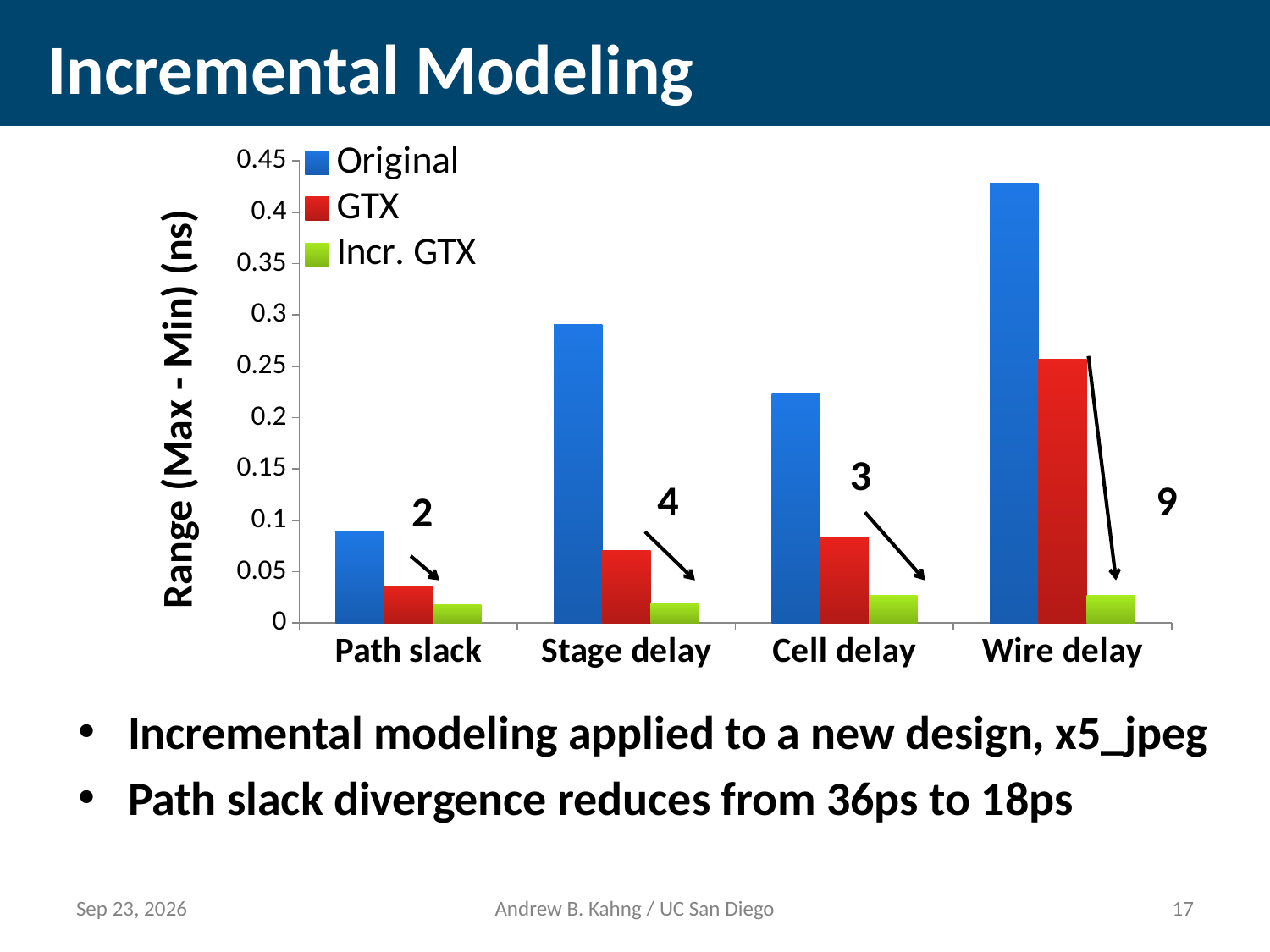
Which is larger, the GTX value for Path slack or the GTX value for Stage delay? Stage delay Which category has the highest GTX value? Wire delay Is the GTX value for Path slack greater or less than 0.05? less Which category has the highest Original value? Wire delay Which category has the lowest Original value? Path slack What kind of chart is shown on the slide? bar chart Is the Original value for Wire delay greater or less than 0.4? greater Is the GTX value for Wire delay greater or less than 0.2? greater How many series does the legend list? 3 How many categories are shown on the x axis? 4 What is the label of the y axis? Range (Max - Min) (ns)